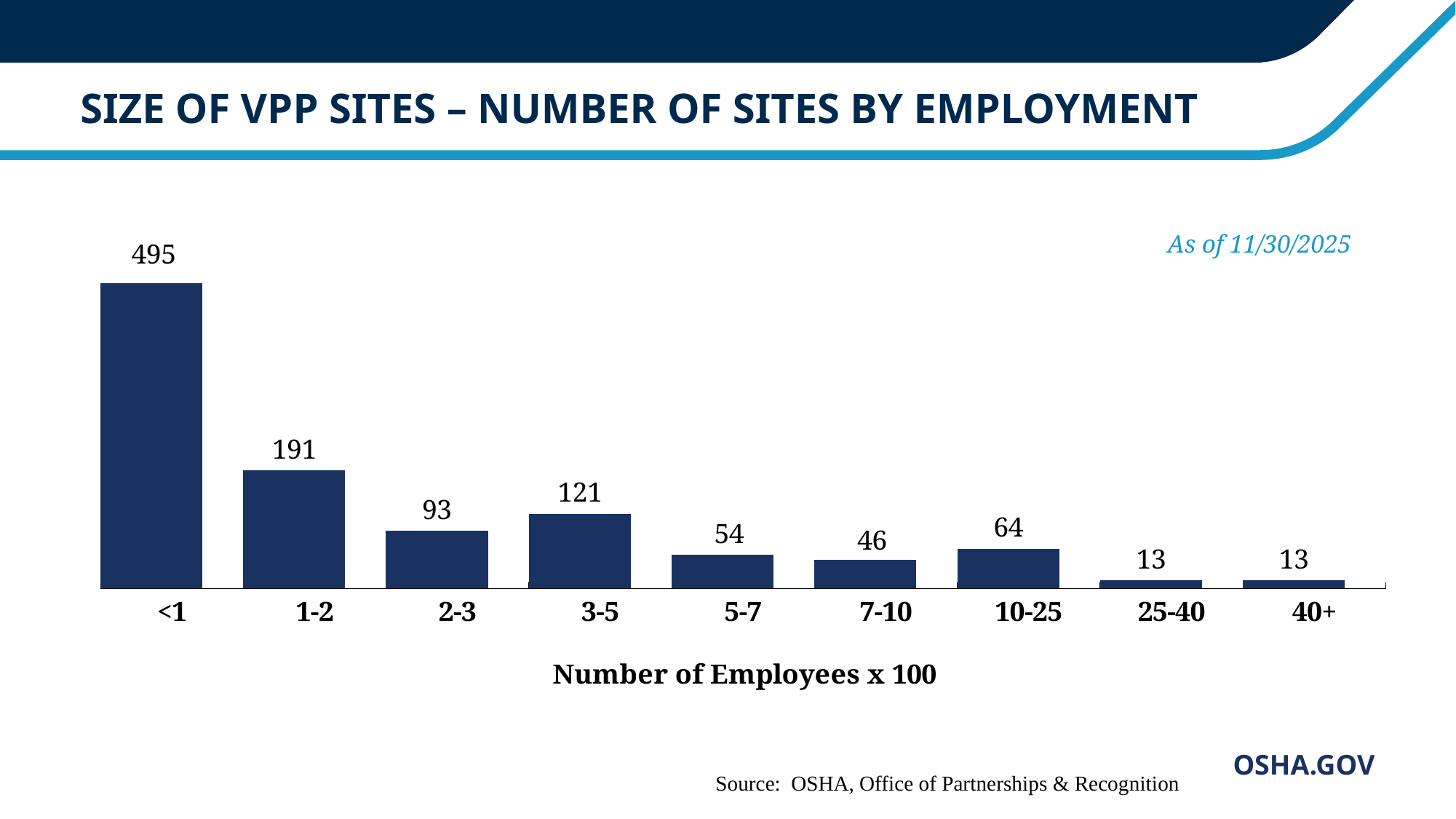
What is the difference in number of sites between the <1 and 1-2 categories? 304 As of what date is the chart data reported? 11/30/2025 What is the difference in number of sites between the 3-5 and 2-3 categories? 28 What is the number of sites for the 3-5 employment category? 121 What is the x-axis label of the chart? Number of Employees x 100 What kind of chart is shown on the slide? Bar chart What is the number of sites for the 10-25 employment category? 64 What is the number of sites for the <1 employment category? 495 Which employment category has the highest number of sites? <1 Which has more sites, the 10-25 category or the 2-3 category? 2-3 How many employment categories are shown on the x axis? 9 Which has more sites, the 5-7 category or the 7-10 category? 5-7